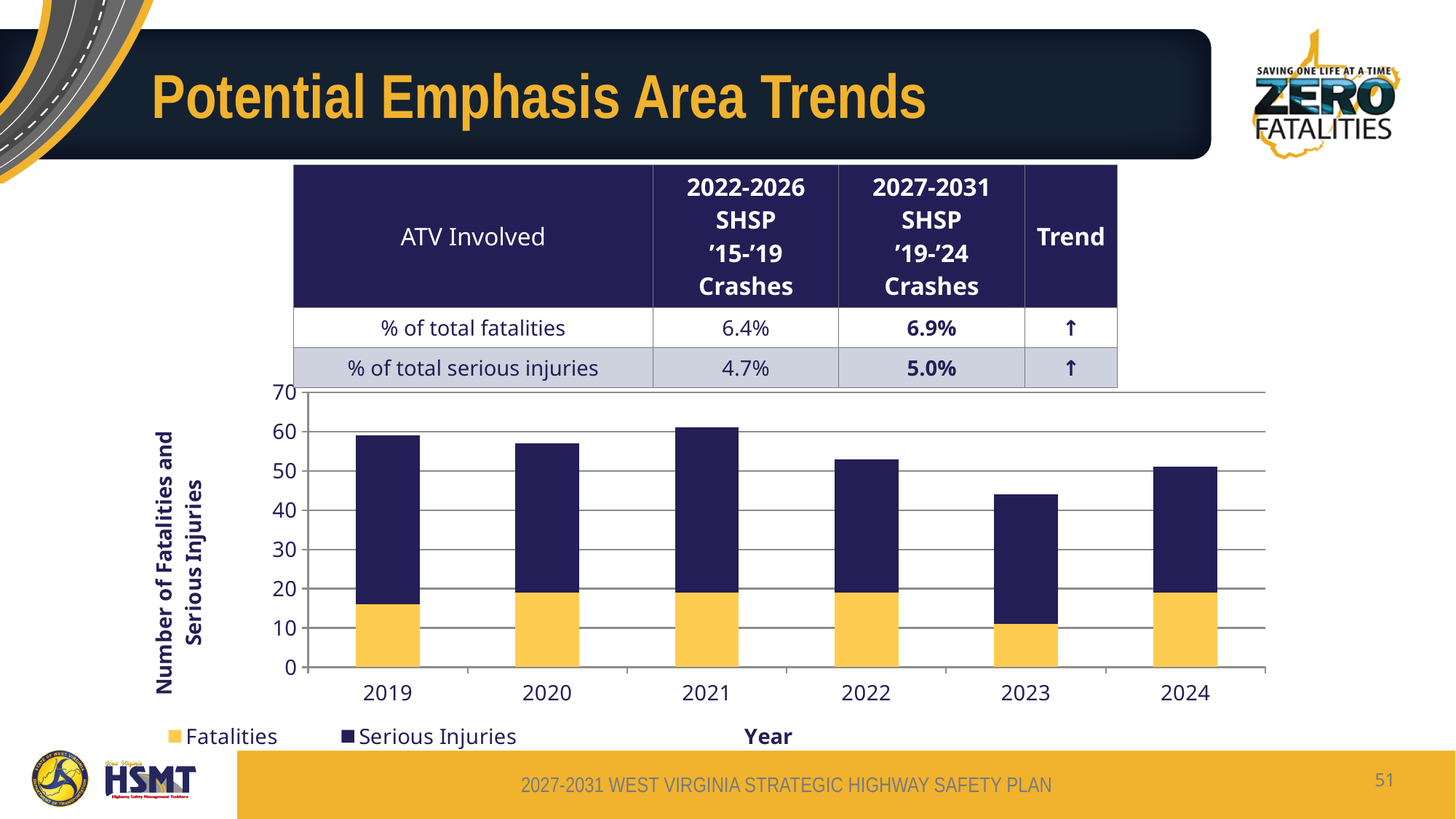
What is the title of the chart's y axis? Number of Fatalities and Serious Injuries Between 2021 and 2023, do the bar totals rise or fall? fall What kind of chart is shown on the slide? Stacked bar chart Is the total for 2023 greater or less than 50? less Which year has the lowest number of fatalities? 2023 Which year has the larger total, 2019 or 2022? 2019 Which year has the lowest total of fatalities and serious injuries? 2023 How many years are shown on the x axis of the chart? 6 Is the total for 2021 greater or less than 50? greater Which year has the larger total, 2023 or 2024? 2024 How many series does the chart legend list? 2 Is the number of fatalities in 2019 greater or less than 20? less